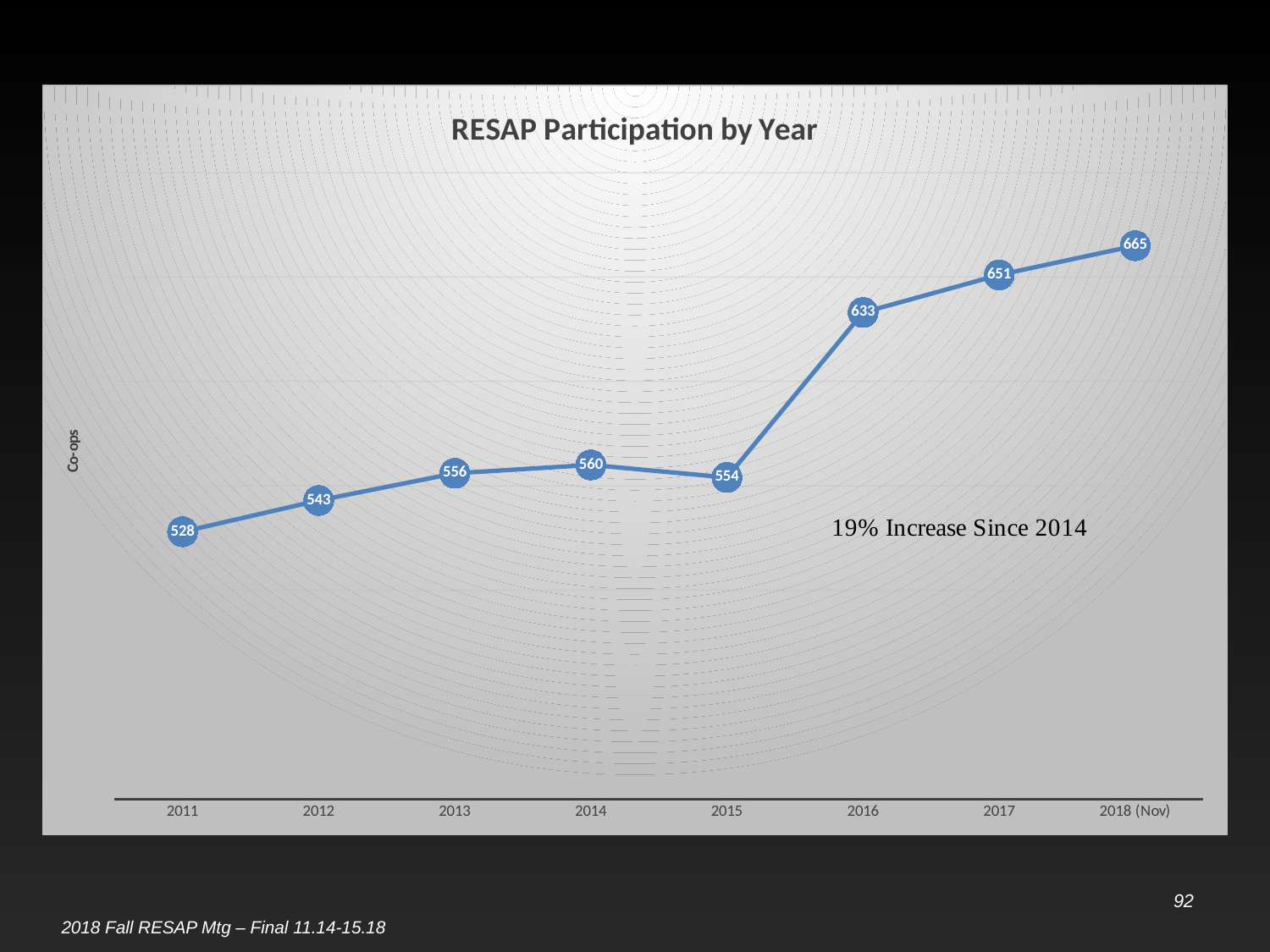
What is the value for 2016? 633 What kind of chart is this? line chart Which year has the lowest value? 2011 What is the value for 2011? 528 What is the value for 2018 (Nov)? 665 Which is larger, the value for 2014 or the value for 2015? 2014 What is the title of the chart? RESAP Participation by Year What is the difference between the values for 2017 and 2016? 18 How many years are plotted on the x axis? 8 What is the difference between the values for 2018 (Nov) and 2011? 137 Which year has the highest value? 2018 (Nov) Do the values generally rise or fall from 2011 to 2018 (Nov)? rise